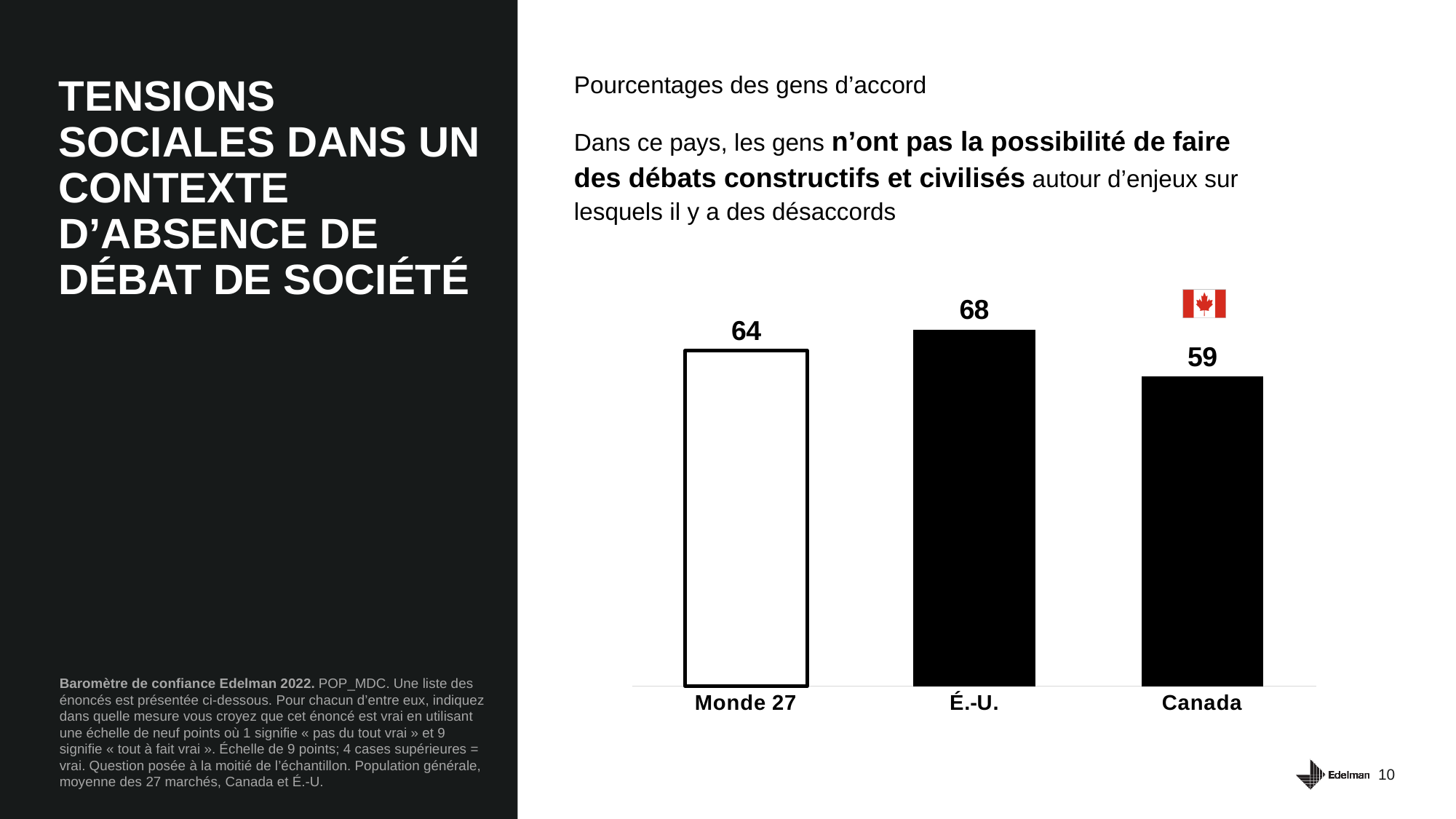
What is the value for É.-U.? 68 Which category has a flag icon above its bar? Canada What is the difference between the values for Monde 27 and Canada? 5 Which category has the highest value? É.-U. Which category has the lowest value? Canada What kind of chart is shown on the slide? Bar chart Which bar is drawn as a white outline rather than filled black? Monde 27 Which is larger, the value for Monde 27 or the value for É.-U.? É.-U. What is the value for Canada? 59 How many categories are shown in the chart? 3 What is the value for Monde 27? 64 What is the difference between the values for É.-U. and Canada? 9